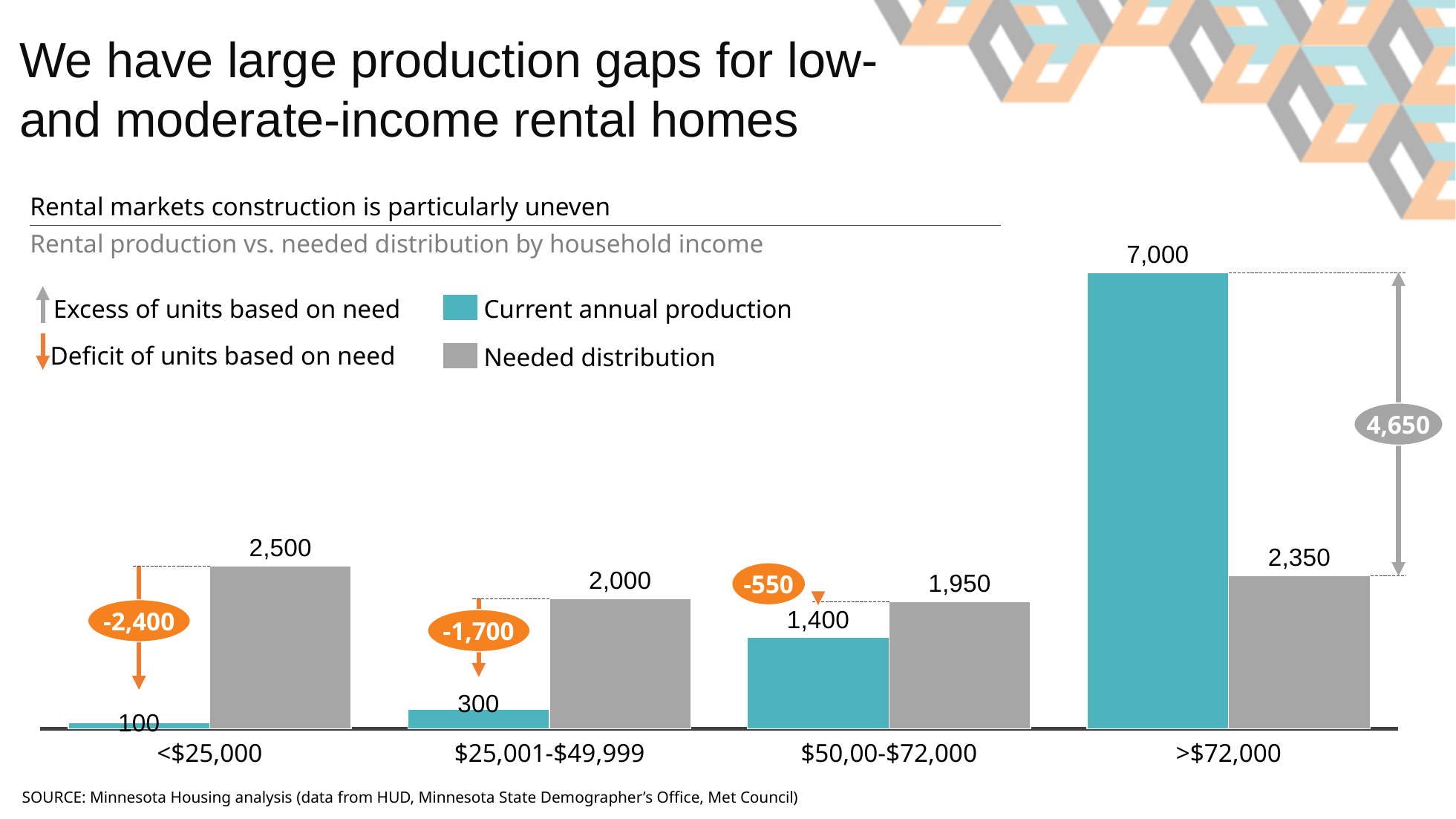
Which income group has the highest current annual production? >$72,000 What is the needed distribution for the $25,001-$49,999 income group? 2,000 Which income group has the lowest needed distribution? $50,00-$72,000 How many income groups are shown on the x axis? 4 What is the current annual production for the <$25,000 income group? 100 What colour represents current annual production in the chart? Teal What is the difference between current annual production and needed distribution for the >$72,000 income group? 4,650 What kind of chart is shown on the slide? Bar chart What is the current annual production for the >$72,000 income group? 7,000 How many bar series does the legend list? 2 What is the difference between needed distribution and current annual production for the $50,00-$72,000 income group? 550 Is current annual production or needed distribution larger for the $25,001-$49,999 income group? Needed distribution